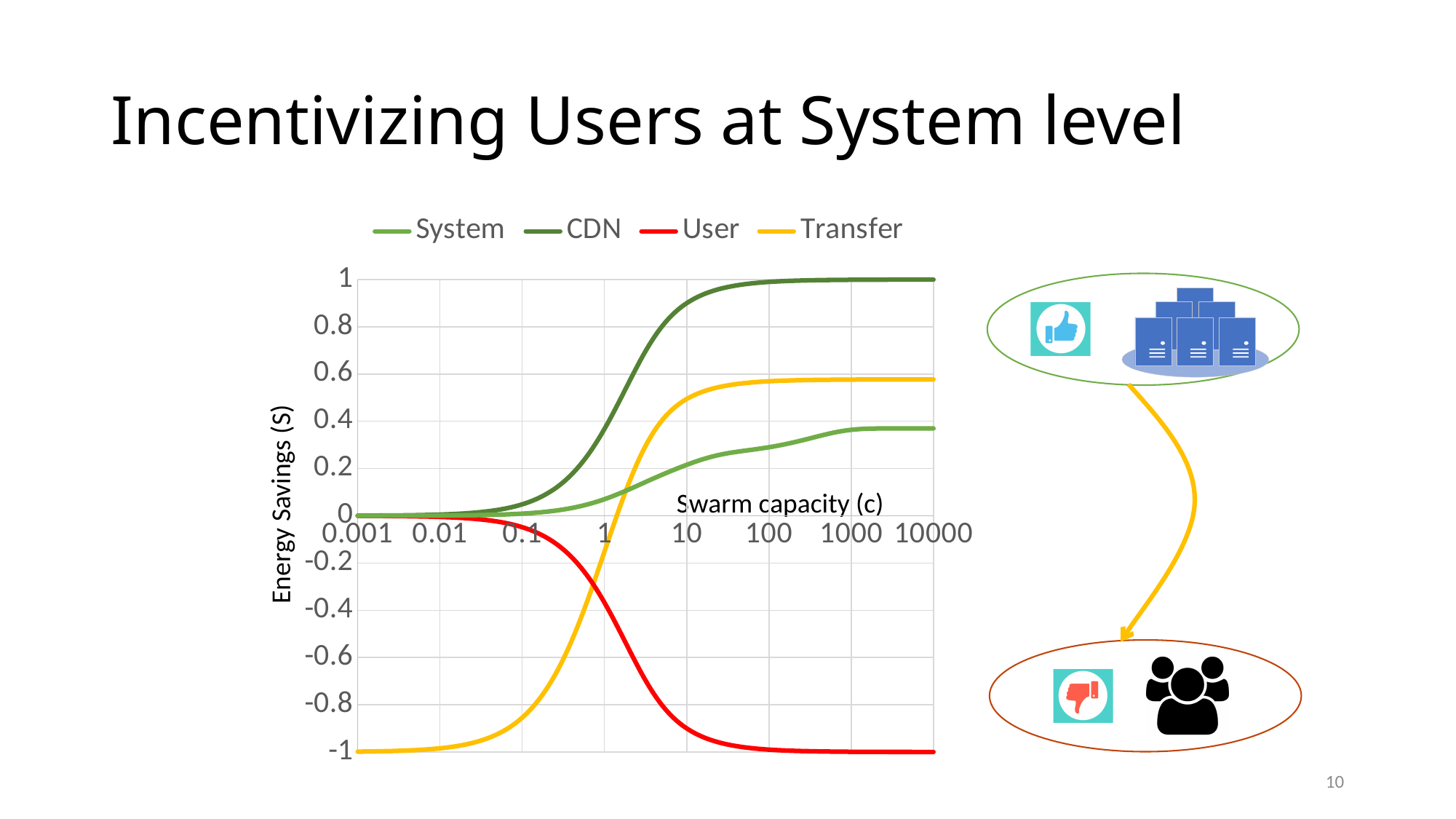
Does the User series rise or fall as swarm capacity increases? fall Does the CDN series rise or fall as swarm capacity increases? rise Which series has the highest value at a swarm capacity of 10000? CDN Which series has the lowest value at a swarm capacity of 10000? User Is the value of the User series at a swarm capacity of 1 greater or less than 0? less How many series does the chart's legend list? 4 At a swarm capacity of 10000, which is larger: the Transfer value or the System value? Transfer What is the label of the vertical axis? Energy Savings (S) Is the value of the System series at a swarm capacity of 10000 greater or less than 0.2? greater What kind of chart is shown on the slide? line chart Is the value of the Transfer series at a swarm capacity of 10000 greater or less than 0.4? greater Which series is drawn in red? User